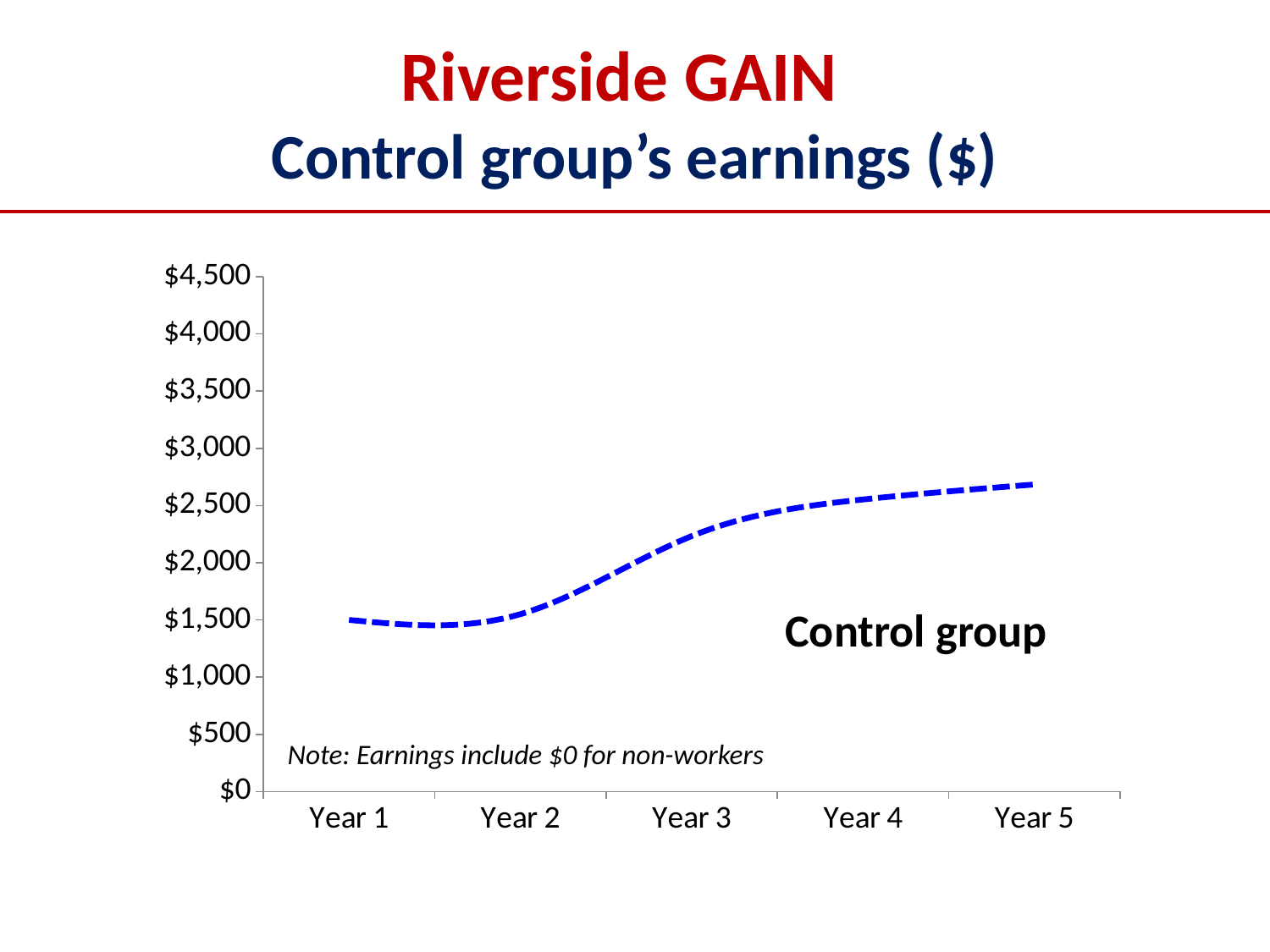
How many data series does the chart plot? 1 In which year are the control group's earnings highest? Year 5 Do the control group's earnings rise or fall from Year 1 to Year 5? Rise What is the name of the series plotted on the chart? Control group How many years are plotted along the x axis? 5 Is the value for Year 5 greater or less than $2,500? greater Is the value for Year 3 greater or less than $2,000? greater Is the value for Year 1 greater or less than $2,000? less Which is larger, the control group's earnings in Year 1 or in Year 3? Year 3 What does the note on the chart say? Note: Earnings include $0 for non-workers What kind of chart is shown on the slide? Line chart